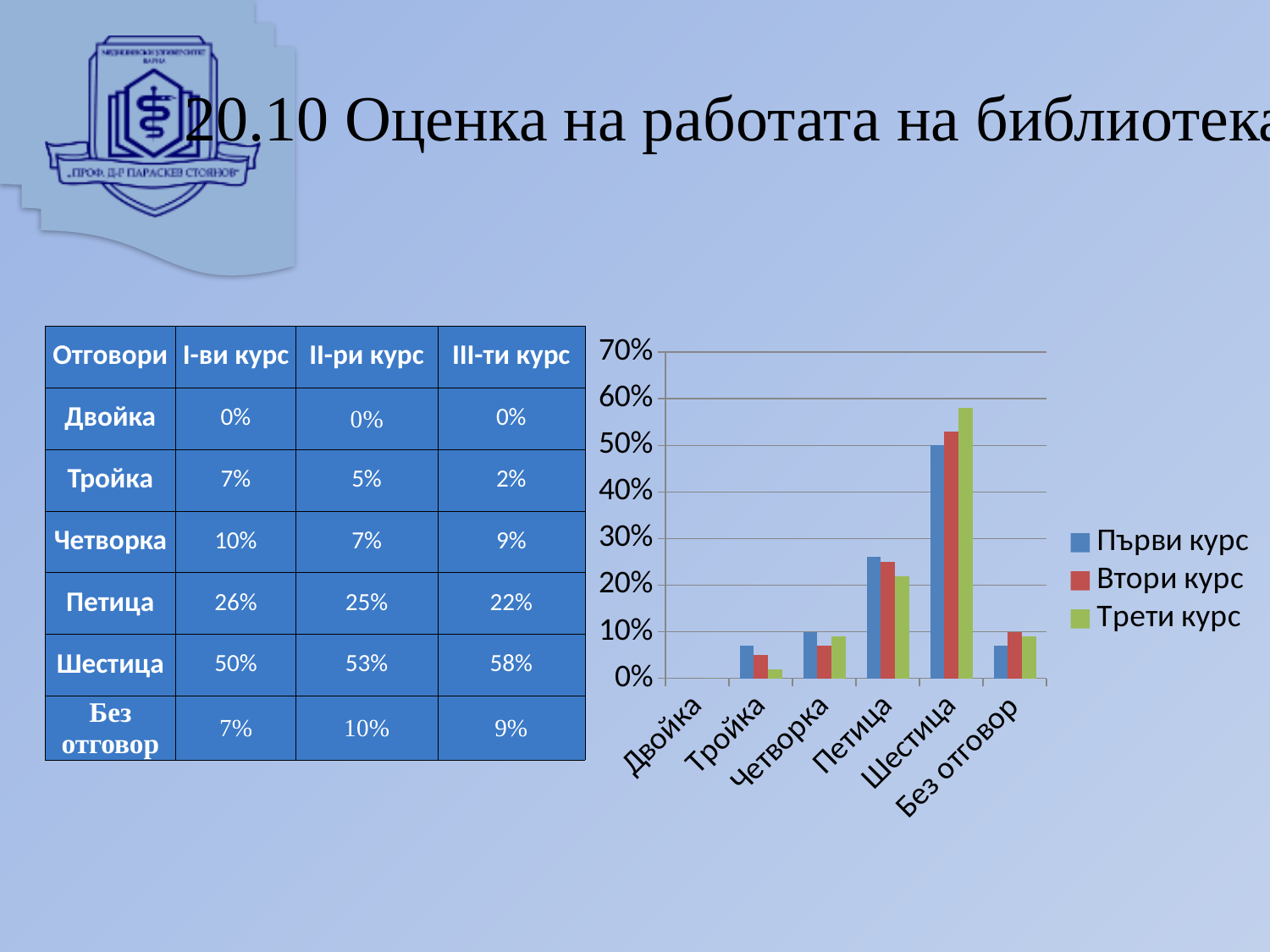
In the Тройка category, which series has the larger value: Първи курс or Трети курс? Първи курс According to the table on the slide, what is the value for Петица for I-ви курс? 26% Is the value for Първи курс in the Петица category greater or less than 30%? less What kind of chart is shown on the slide? bar chart Using the values in the table, what is the difference between Шестица for III-ти курс and Шестица for I-ви курс? 8% Which series has the tallest bar for the Шестица category? Трети курс Is the value for Трети курс in the Шестица category greater or less than 50%? greater Which legend entry is shown in green? Трети курс How many categories are shown on the x axis of the chart? 6 How many series does the chart legend list? 3 Which category has the highest value for Първи курс? Шестица According to the table on the slide, what is the value for Шестица for III-ти курс? 58%